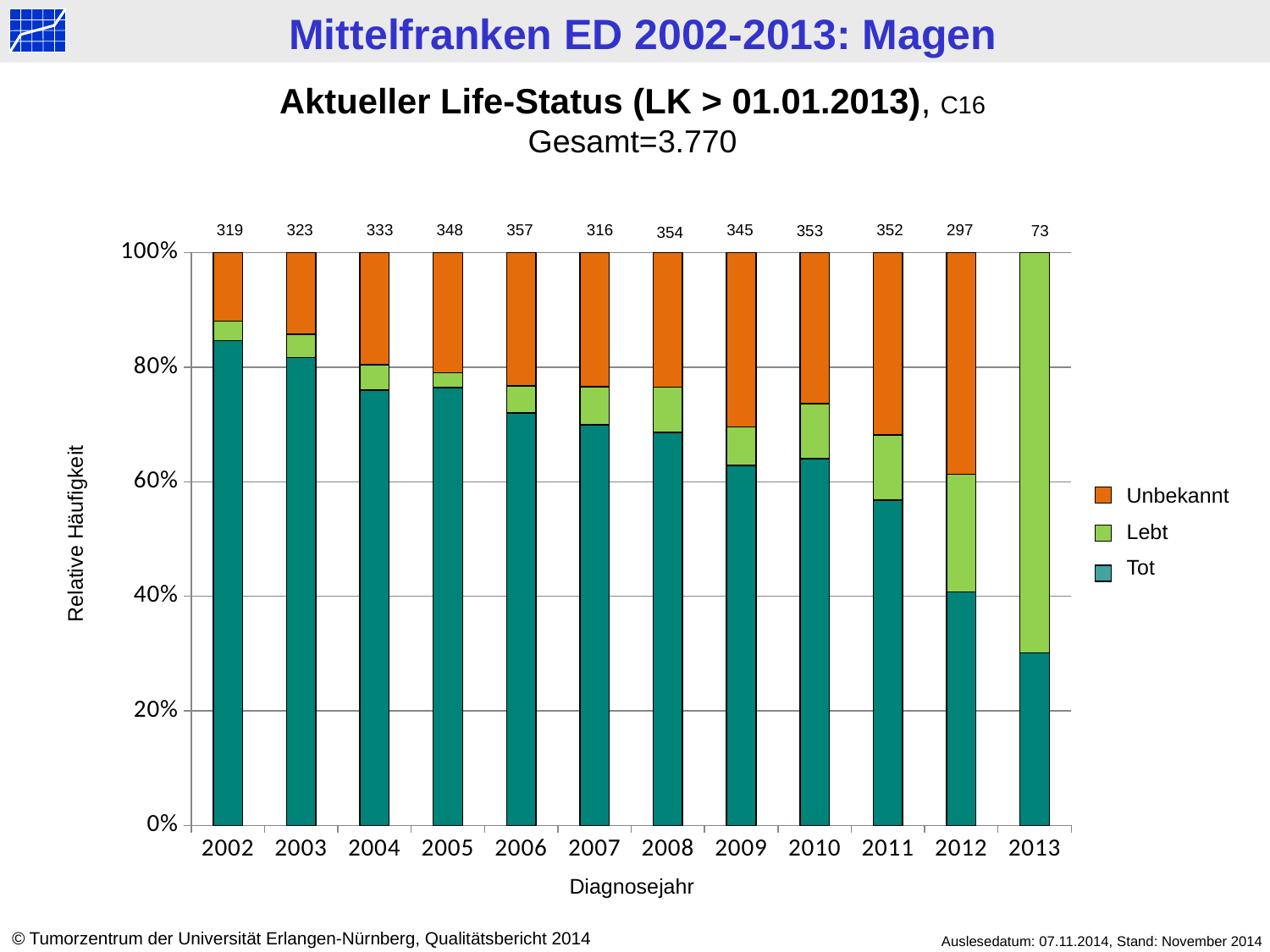
What is the difference between the numbers printed above the bars for 2006 and 2013? 284 Which diagnosis year has the highest number printed above its bar? 2006 Does the share of 'Tot' rise or fall from 2002 to 2013? Fall Is the share of 'Tot' for 2002 greater or less than 80%? greater How many series does the legend list? 3 Which diagnosis year has the lowest number printed above its bar? 2013 Which has the larger number printed above its bar, 2002 or 2003? 2003 What is the number printed above the bar for 2006? 357 How many diagnosis years are shown on the x axis? 12 What kind of chart is shown on the slide? Stacked bar chart Is the share of 'Tot' for 2013 greater or less than 40%? less What is the number printed above the bar for 2013? 73